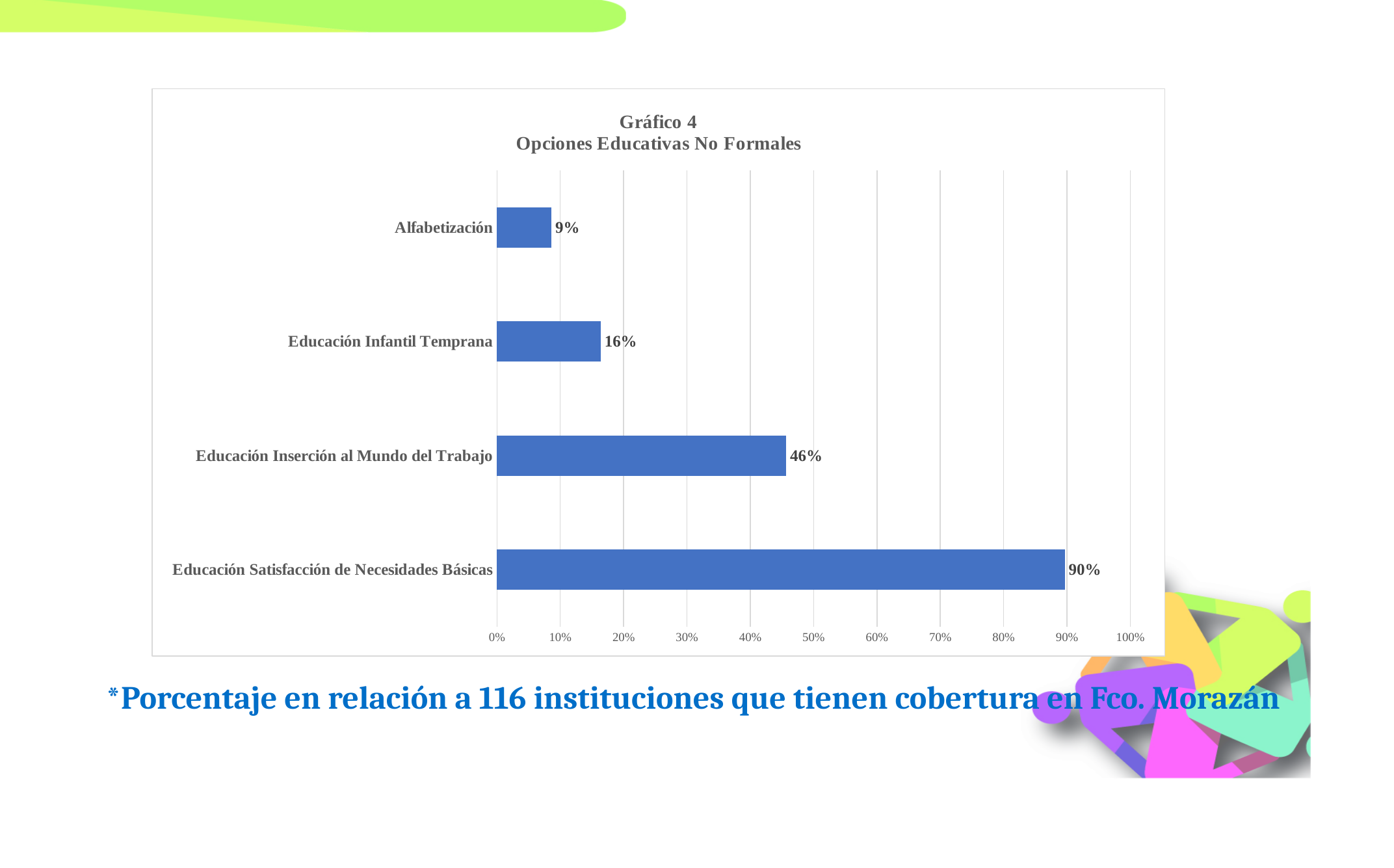
What is the value for Educación Inserción al Mundo del Trabajo? 46% Which category has the lowest value? Alfabetización What kind of chart is shown on the slide? bar chart What is the value for Educación Satisfacción de Necesidades Básicas? 90% How many categories are shown in the chart? 4 What is the value for Educación Infantil Temprana? 16% Which is larger, Educación Infantil Temprana or Alfabetización? Educación Infantil Temprana What is the value for Alfabetización? 9% Which category has the highest value? Educación Satisfacción de Necesidades Básicas Is the value for Educación Inserción al Mundo del Trabajo greater or less than 50%? less What is the difference between Educación Satisfacción de Necesidades Básicas and Educación Inserción al Mundo del Trabajo? 44% What is the title of the chart? Gráfico 4 Opciones Educativas No Formales